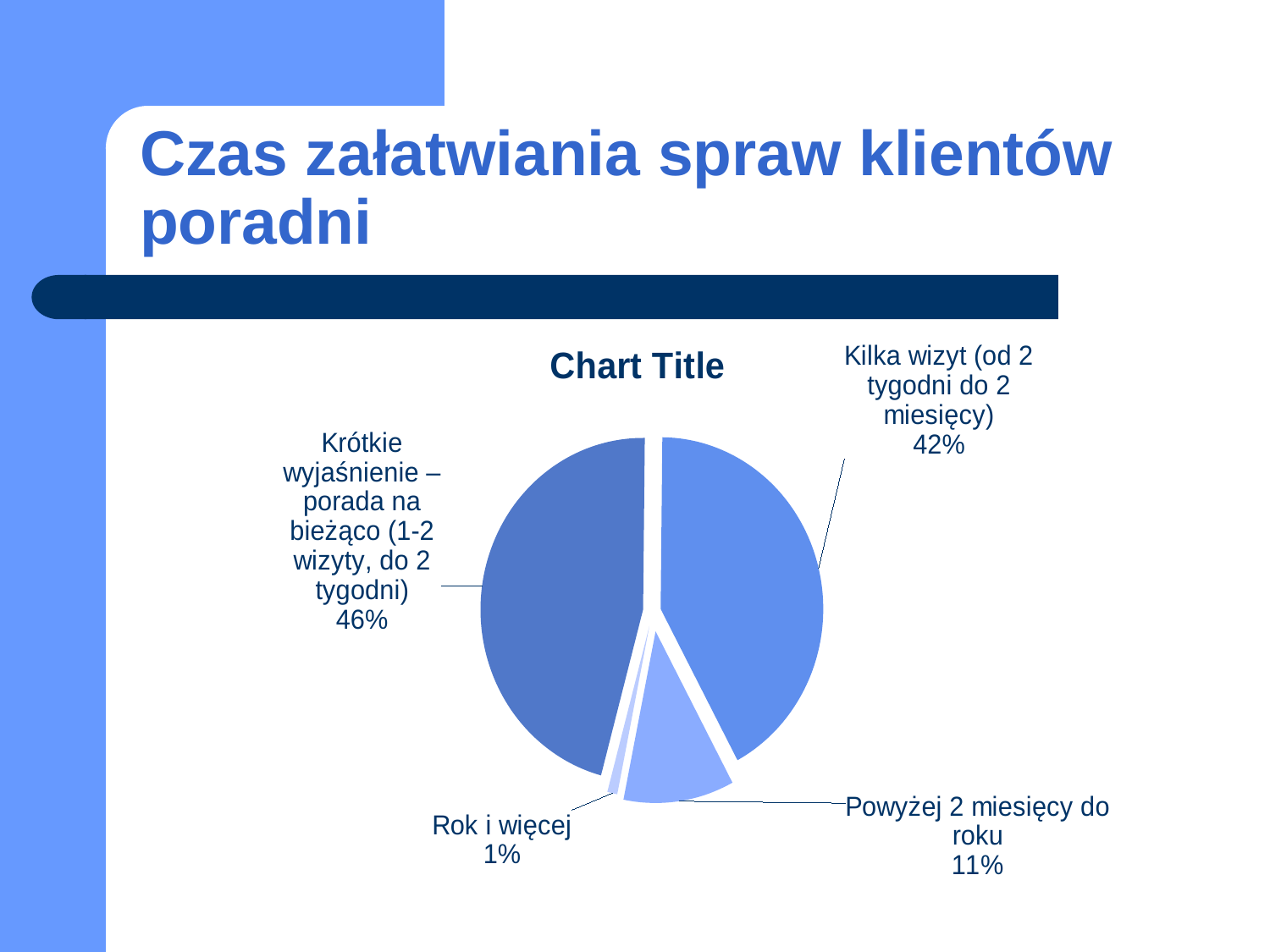
What is the title printed above the pie chart? Chart Title What is the difference in percentage points between the "Powyżej 2 miesięcy do roku" slice and the "Rok i więcej" slice? 10 What kind of chart is shown on the slide? pie chart What share of the pie is labelled "Krótkie wyjaśnienie – porada na bieżąco (1-2 wizyty, do 2 tygodni)"? 46% What share of the pie is labelled "Kilka wizyt (od 2 tygodni do 2 miesięcy)"? 42% Which slice of the pie is the smallest? Rok i więcej What share of the pie is labelled "Powyżej 2 miesięcy do roku"? 11% What is the difference in percentage points between the "Krótkie wyjaśnienie" slice and the "Kilka wizyt" slice? 4 What share of the pie is labelled "Rok i więcej"? 1% How many slices does the pie chart have? 4 Which slice of the pie is the largest? Krótkie wyjaśnienie – porada na bieżąco (1-2 wizyty, do 2 tygodni) Which is larger: the "Kilka wizyt (od 2 tygodni do 2 miesięcy)" slice or the "Powyżej 2 miesięcy do roku" slice? Kilka wizyt (od 2 tygodni do 2 miesięcy)